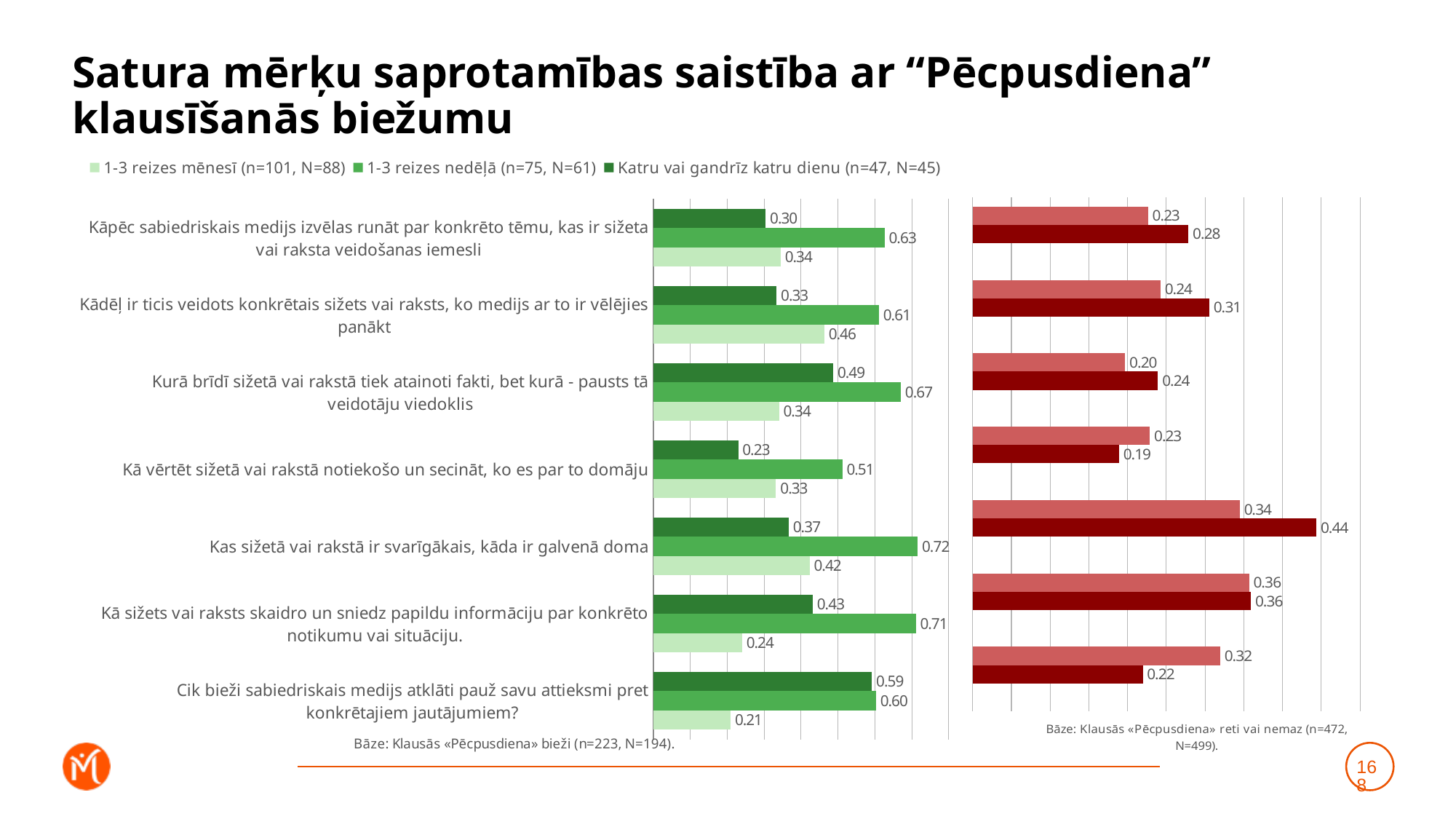
In the left (green) chart, which category has the lowest value in the series "Katru vai gandrīz katru dienu (n=47, N=45)"? Kā vērtēt sižetā vai rakstā notiekošo un secināt, ko es par to domāju In the left (green) chart, which category has the highest value in the series "1-3 reizes nedēļā (n=75, N=61)"? Kas sižetā vai rakstā ir svarīgākais, kāda ir galvenā doma In the left (green) chart, what is the value for "Kā sižets vai raksts skaidro un sniedz papildu informāciju par konkrēto notikumu vai situāciju." in the series "1-3 reizes mēnesī (n=101, N=88)"? 0.24 How many series does the legend of the left (green) chart list? 3 What kind of chart is shown on the left side of the slide? bar chart In the left (green) chart, what is the value for "Kas sižetā vai rakstā ir svarīgākais, kāda ir galvenā doma" in the series "1-3 reizes nedēļā (n=75, N=61)"? 0.72 In the left (green) chart, for "Kādēļ ir ticis veidots konkrētais sižets vai raksts, ko medijs ar to ir vēlējies panākt", which series has the larger value: "1-3 reizes mēnesī" or "Katru vai gandrīz katru dienu"? 1-3 reizes mēnesī What base note is printed below the left (green) chart? Bāze: Klausās «Pēcpusdiena» bieži (n=223, N=194). In the left (green) chart, for "Cik bieži sabiedriskais medijs atklāti pauž savu attieksmi pret konkrētajiem jautājumiem?", what is the difference between the "1-3 reizes nedēļā" value and the "1-3 reizes mēnesī" value? 0.39 How many categories (questions) are plotted in the left (green) chart? 7 In the left (green) chart, what is the value for "Cik bieži sabiedriskais medijs atklāti pauž savu attieksmi pret konkrētajiem jautājumiem?" in the series "Katru vai gandrīz katru dienu (n=47, N=45)"? 0.59 In the right (red) chart, what is the value of the dark red bar for "Kas sižetā vai rakstā ir svarīgākais, kāda ir galvenā doma"? 0.44